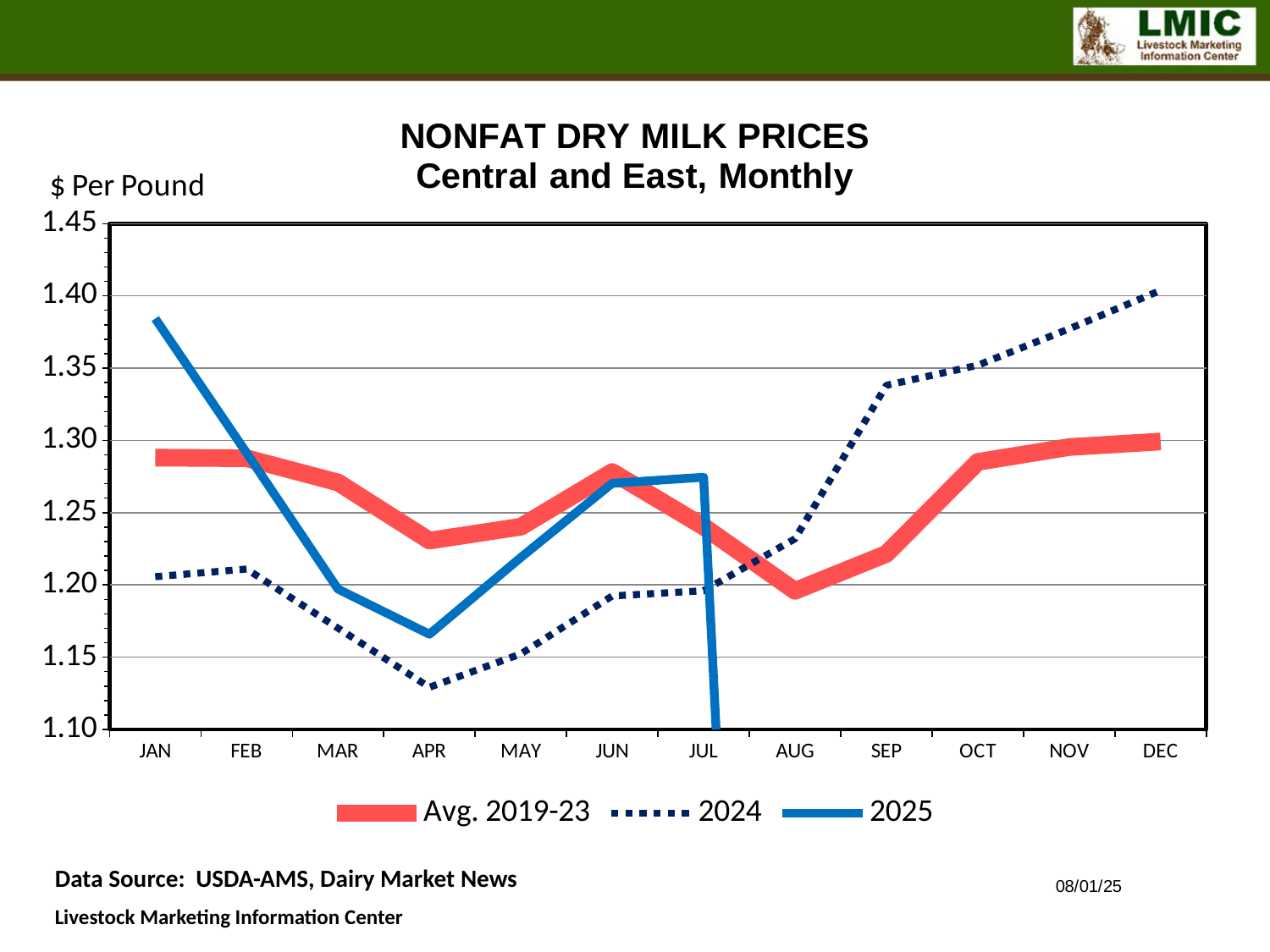
What kind of chart is shown on the slide? line chart In JAN, which series is higher: 2025 or Avg. 2019-23? 2025 Is the 2024 value for DEC greater or less than 1.35? greater In which month is the 2024 series at its lowest? APR Is the 2025 value for JAN greater or less than 1.35? greater What is the label on the y axis? $ Per Pound How many months are shown along the x axis? 12 Is the 2024 value for APR greater or less than 1.15? less In which month is the 2024 series at its highest? DEC Does the 2024 series rise or fall from SEP to DEC? rise How many series does the legend list? 3